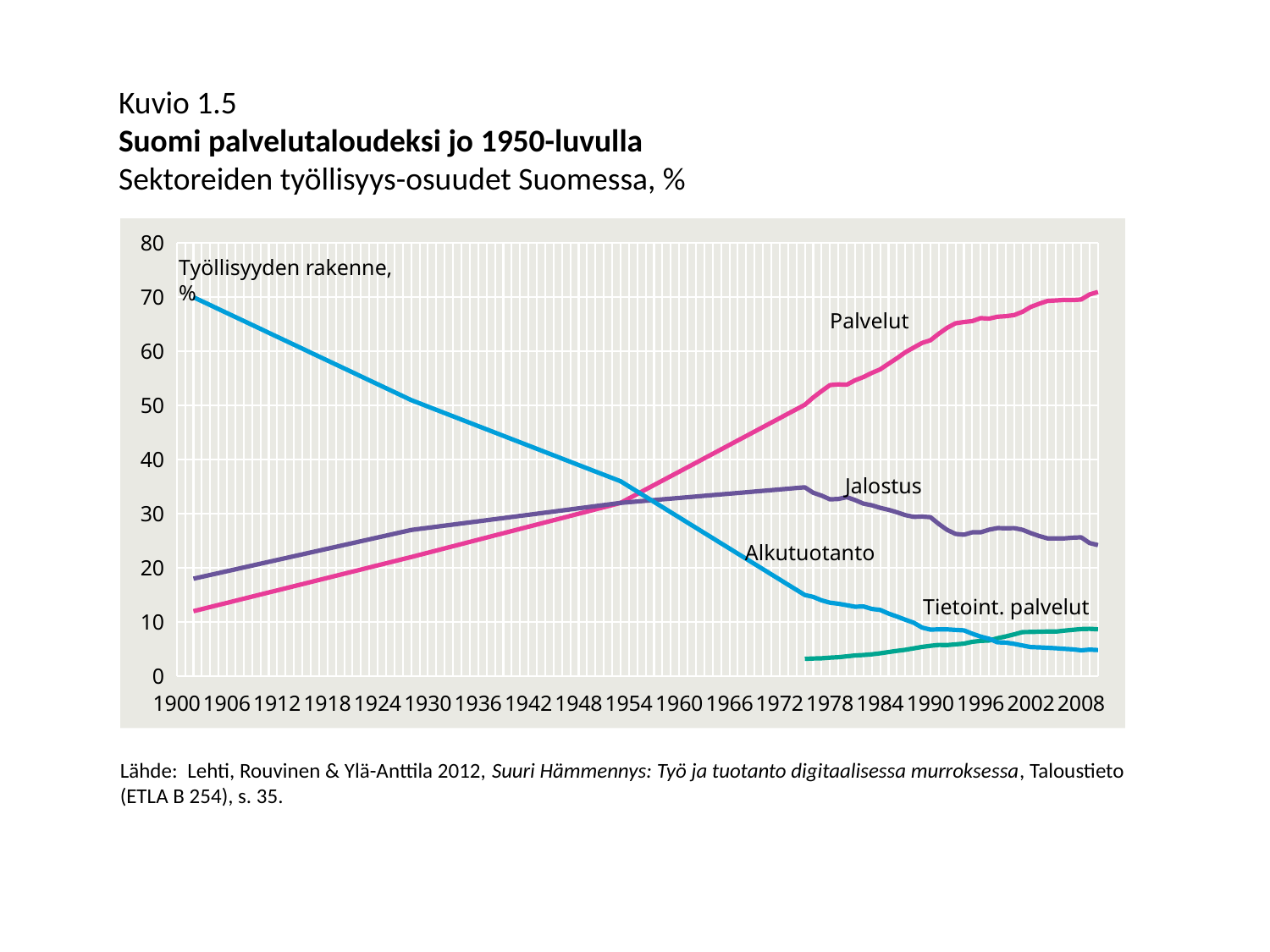
In 2008, which is larger: Palvelut or Jalostus? Palvelut Does the Palvelut line rise or fall from 1900 to 2008? rises Is the value for Jalostus in 1900 greater or less than 20? less How many series (lines) are plotted on the chart? 4 What kind of chart is shown on the slide? line chart Which series has the highest value in 1900? Alkutuotanto Is the value for Palvelut in 2008 greater or less than 60? greater Is the value for Tietoint. palvelut in 2008 greater or less than 10? less Does the Alkutuotanto line rise or fall from 1900 to 2008? falls What is the bold title of the chart on the slide? Suomi palvelutaloudeksi jo 1950-luvulla Which series has the highest value in 2008? Palvelut